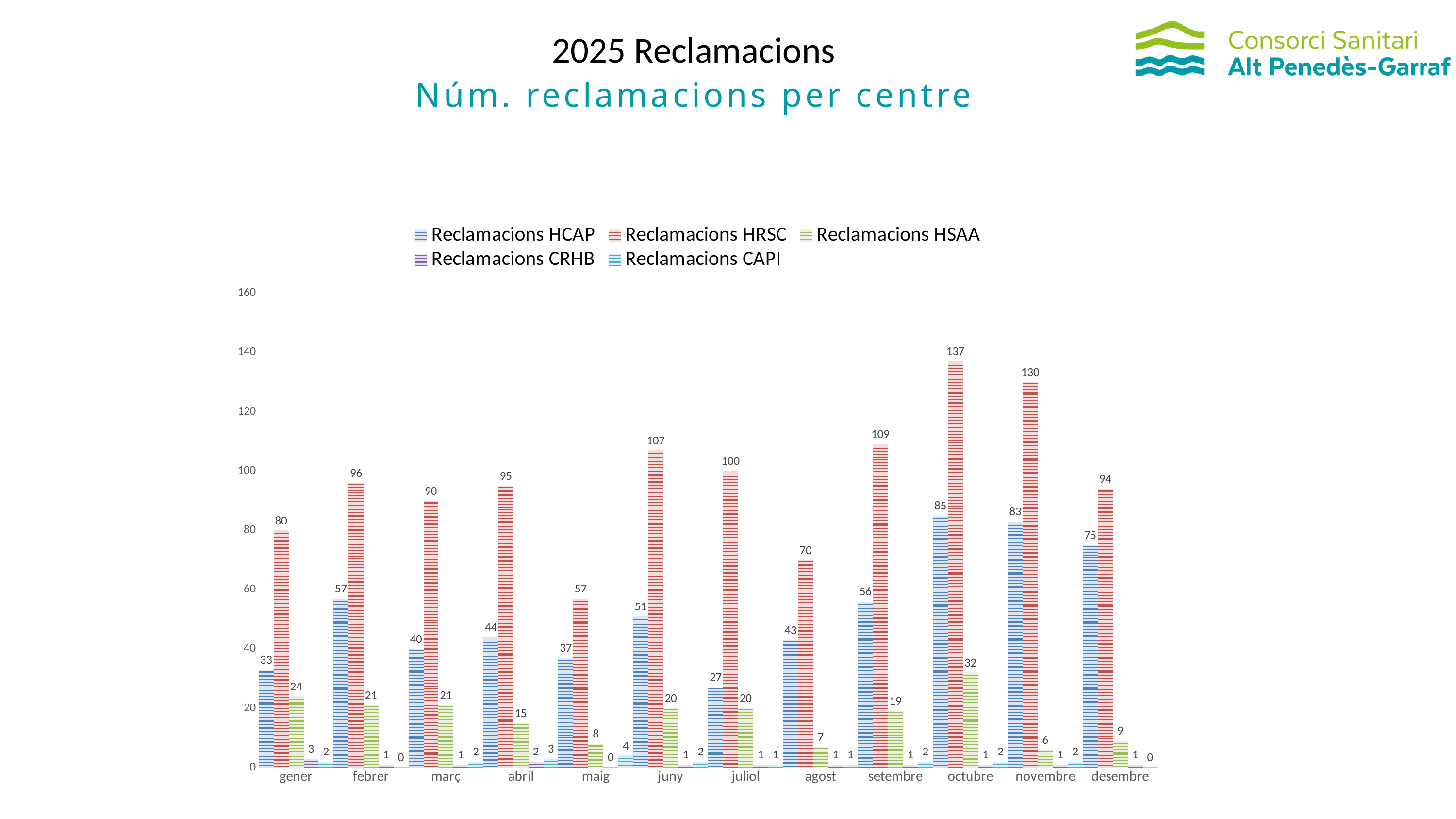
Which is larger in maig: Reclamacions HCAP or Reclamacions HSAA? Reclamacions HCAP What kind of chart is shown on the slide? bar chart What is the value of Reclamacions HSAA for octubre? 32 In which month is Reclamacions HCAP lowest? juliol Is the value of Reclamacions HRSC for juny greater or less than 100? greater What is the value of Reclamacions HRSC for octubre? 137 What is the value of Reclamacions HSAA for abril? 15 What is the value of Reclamacions HCAP for febrer? 57 What is the difference between Reclamacions HRSC and Reclamacions HCAP in novembre? 47 How many series does the legend list? 5 In which month is Reclamacions HRSC highest? octubre How many months are shown on the x axis? 12